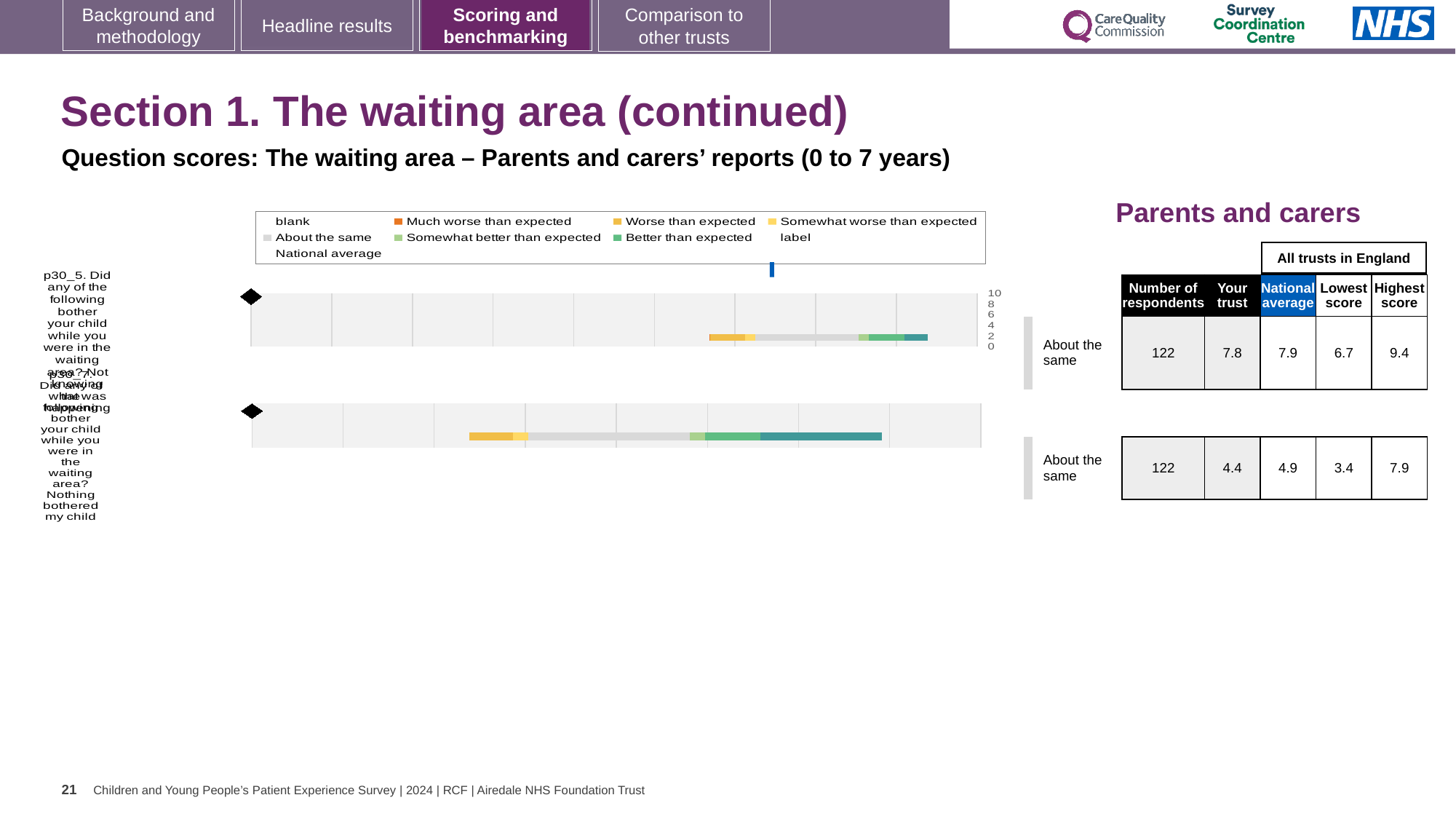
In the table beside the chart, what is the national average for question p30_7? 4.9 In the table beside the chart, how many respondents answered question p30_5? 122 For question p30_7, what is the difference between the highest score and the lowest score in the table? 4.5 For question p30_5, which is larger: the 'Your trust' score or the national average? National average Which benchmark category is shown beside the bar for question p30_5? About the same In the table beside the chart, what is the 'Your trust' score for question p30_5? 7.8 Which benchmark category is shown beside the bar for question p30_7? About the same What kind of chart is used to show the question scores for the waiting area? Bar chart How many entries does the chart legend list? 9 Which question has the higher 'Your trust' score, p30_5 or p30_7? p30_5 What colour does the legend use for 'Better than expected'? Teal green How many questions (bar rows) are plotted in the chart? 2